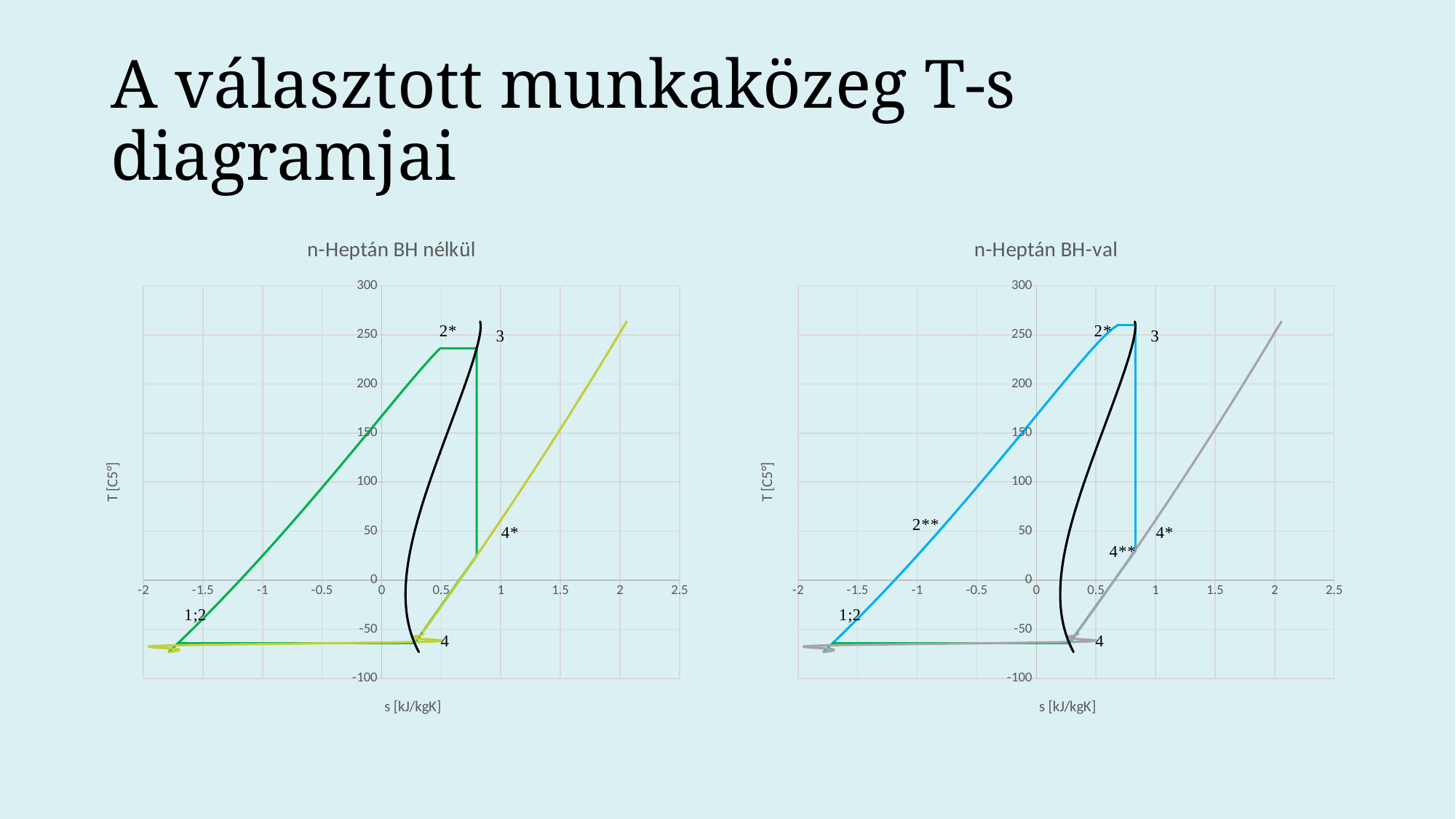
How many labelled state points are marked on the right chart "n-Heptán BH-val"? 7 What kind of chart is the left chart titled "n-Heptán BH nélkül"? line chart In the left chart "n-Heptán BH nélkül", is the temperature at point 4 greater or less than 0? less In the right chart "n-Heptán BH-val", is the temperature at point 2* greater or less than 200? greater In the right chart "n-Heptán BH-val", is the temperature at point 1;2 greater or less than -50? less What is the title of the right chart? n-Heptán BH-val In the right chart "n-Heptán BH-val", which point has the higher temperature, 3 or 4? 3 What is the label of the horizontal axis on the left chart? s [kJ/kgK] In the left chart "n-Heptán BH nélkül", which point has the higher temperature, 2* or 4*? 2* What is the highest value shown on the vertical axis of the left chart? 300